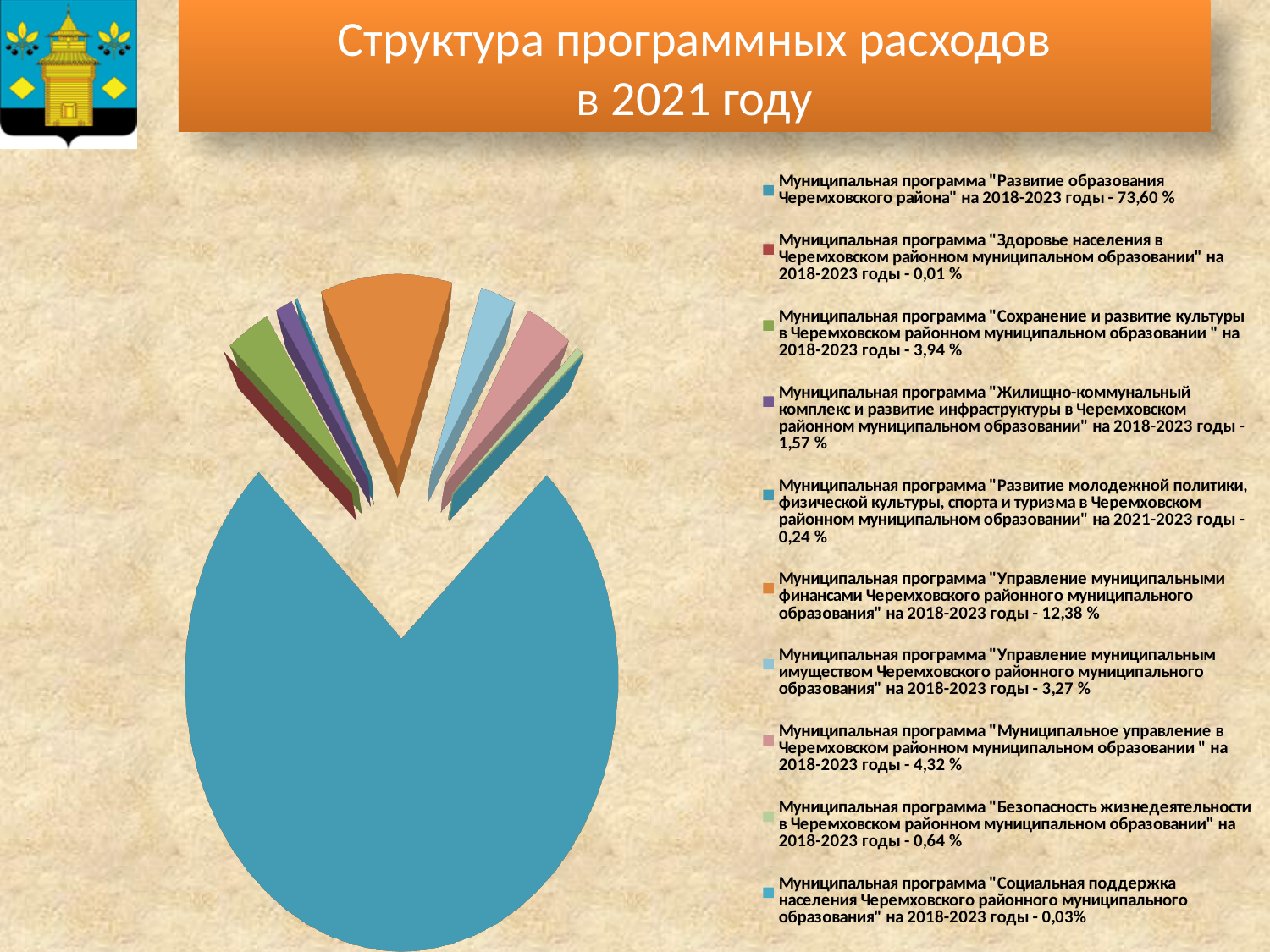
How many programmes does the legend list? 10 Which programme has the smallest share of programme expenditures? Здоровье населения в Черемховском районном муниципальном образовании What share is shown for the programme "Развитие образования Черемховского района"? 73,60 % What is the difference between the shares of "Развитие образования Черемховского района" and "Управление муниципальными финансами Черемховского районного муниципального образования"? 61,22 % What share is shown for the programme "Управление муниципальными финансами Черемховского районного муниципального образования"? 12,38 % What share is shown for the programme "Сохранение и развитие культуры в Черемховском районном муниципальном образовании"? 3,94 % What share is shown for the programme "Жилищно-коммунальный комплекс и развитие инфраструктуры в Черемховском районном муниципальном образовании"? 1,57 % What share is shown for the programme "Безопасность жизнедеятельности в Черемховском районном муниципальном образовании"? 0,64 % Which has the larger share: "Муниципальное управление в Черемховском районном муниципальном образовании" or "Управление муниципальным имуществом Черемховского районного муниципального образования"? Муниципальное управление в Черемховском районном муниципальном образовании What kind of chart is shown on the slide? pie chart Which programme has the largest share of programme expenditures? Развитие образования Черемховского района What is the title of the chart on the slide? Структура программных расходов в 2021 году